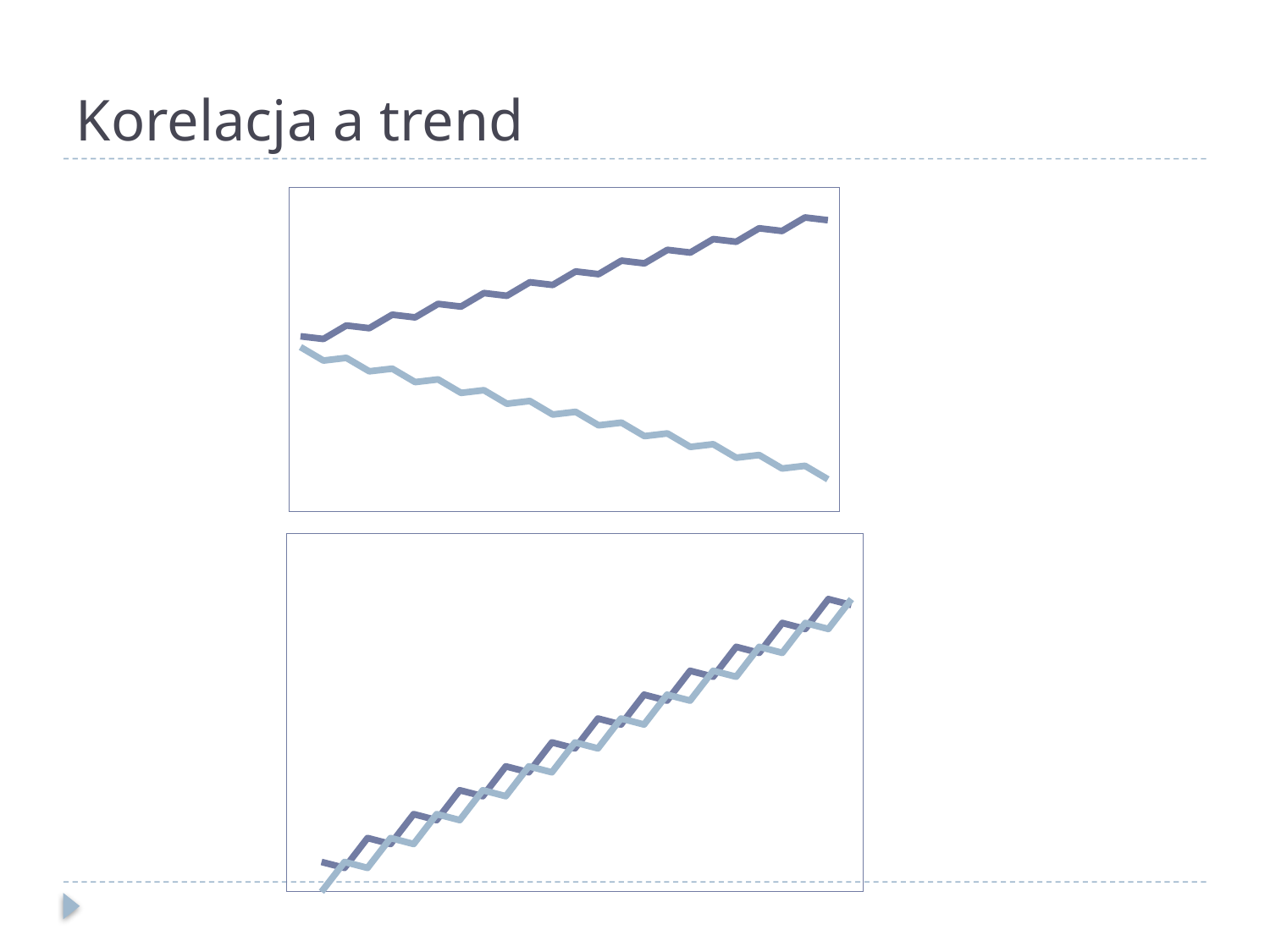
In the top chart, do the two lines move in the same direction or in opposite directions? opposite directions How many lines are plotted in the top chart? 2 In the bottom chart, do the two lines move in the same direction or in opposite directions? same direction In the bottom chart, does the darker line rise or fall from left to right? rise What is the title of the slide containing the charts? Korelacja a trend What kind of chart is the top chart on the slide? line chart What kind of chart is the bottom chart on the slide? line chart How many lines are plotted in the bottom chart? 2 How many charts are shown on the slide? 2